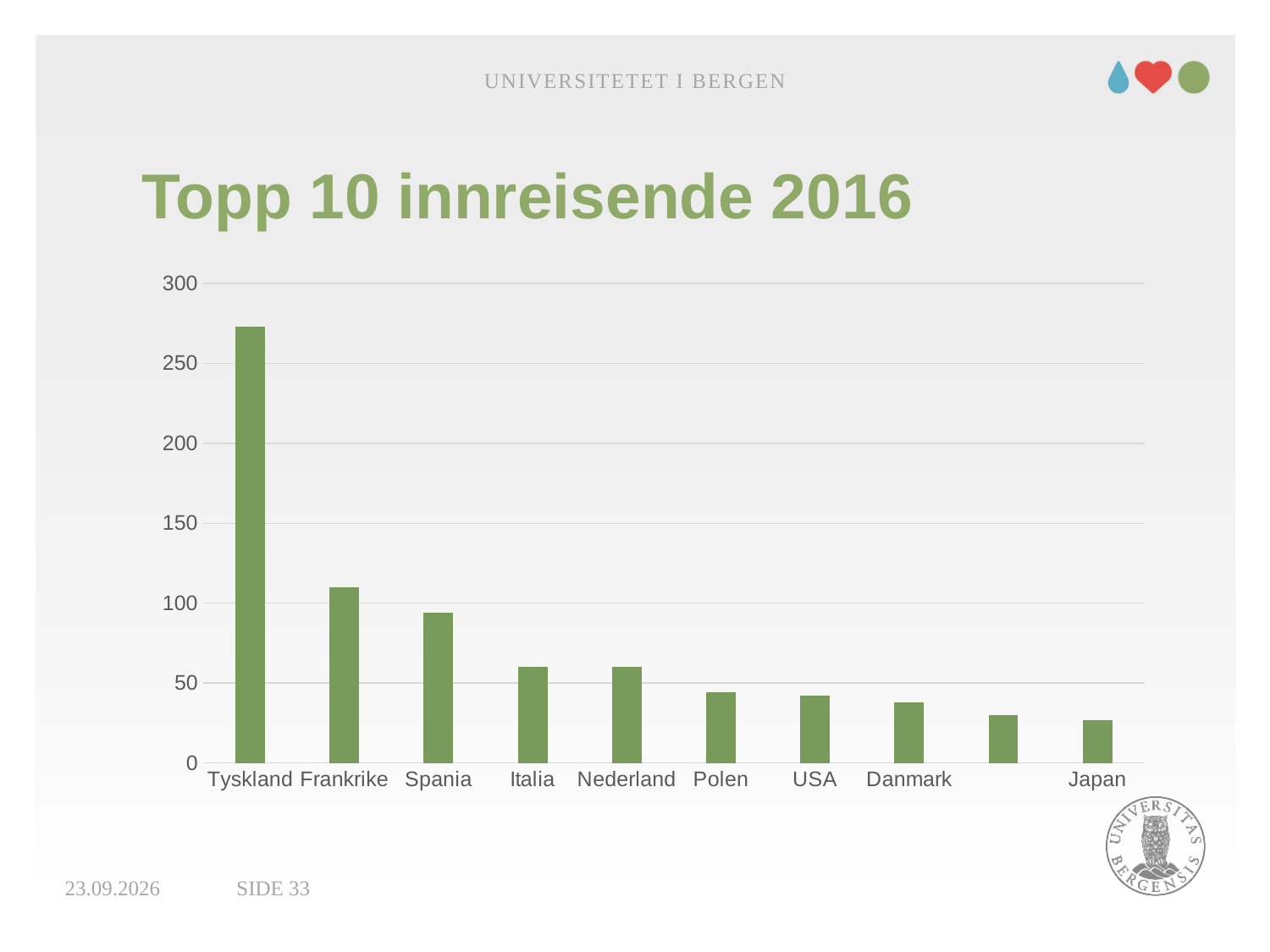
What kind of chart is shown on the slide? bar chart Is the value for Italia greater or less than 50? greater Is the value for Spania greater or less than 100? less What is the title of the chart? Topp 10 innreisende 2016 Which country has the highest bar in the chart? Tyskland Which is larger, the value for Spania or the value for Italia? Spania How many bars are plotted in the chart? 10 Is the value for Polen greater or less than 50? less Which is larger, the value for Tyskland or the value for Frankrike? Tyskland Do the bar values generally rise or fall from left to right along the x axis? fall